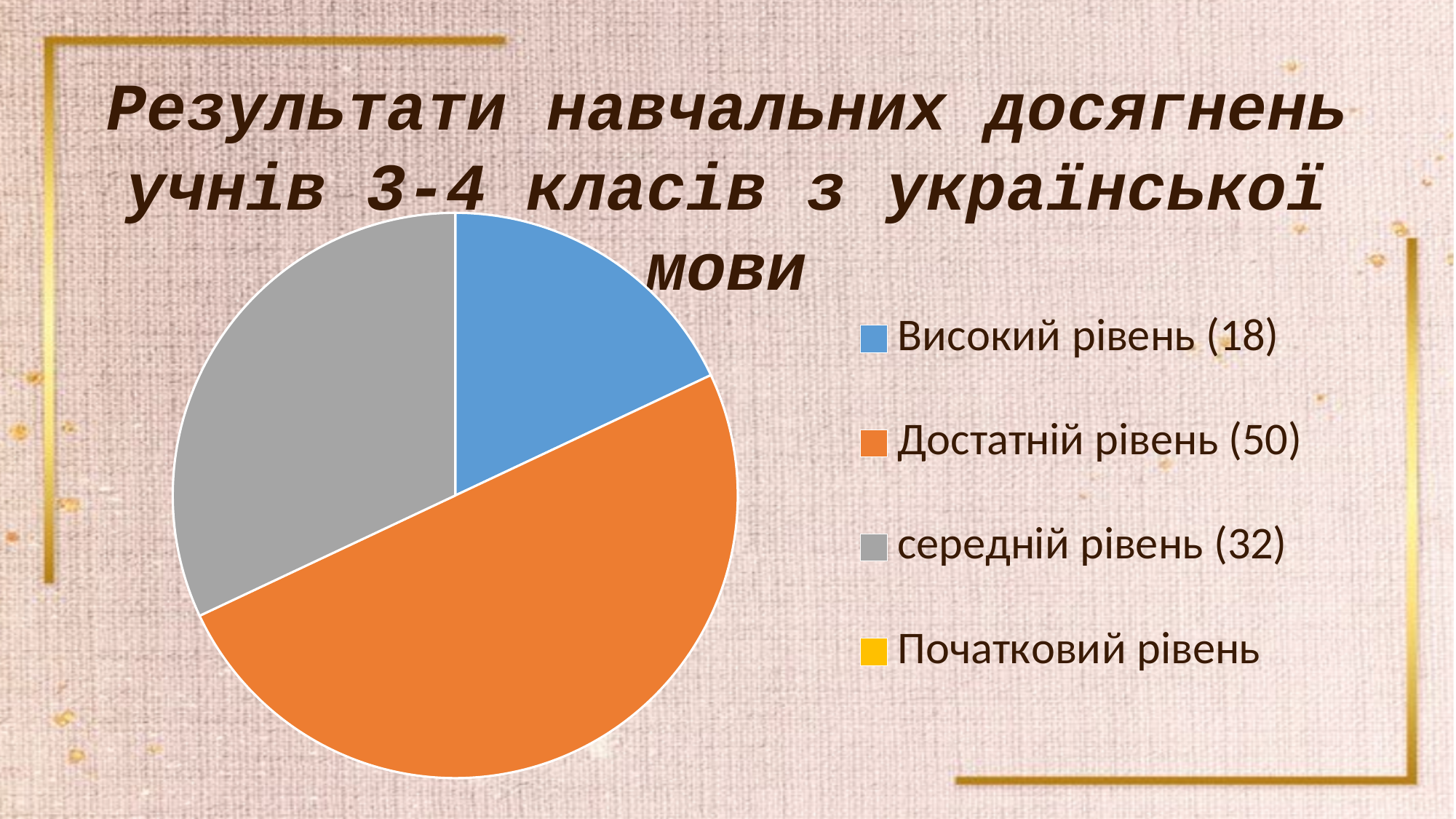
What colour is the slice for середній рівень? grey What is the difference between the values for Достатній рівень and середній рівень? 18 Which level has the largest slice of the pie? Достатній рівень What kind of chart is shown on the slide? pie chart What is the difference between the values for середній рівень and Високий рівень? 14 What value is shown for Високий рівень? 18 What value is shown for середній рівень? 32 How many entries does the legend list? 4 What share of the pie does Достатній рівень take, based on the printed values? 50% Which is larger, the value for середній рівень or the value for Високий рівень? середній рівень Which of the levels with a printed value has the smallest slice? Високий рівень What value is shown for Достатній рівень? 50